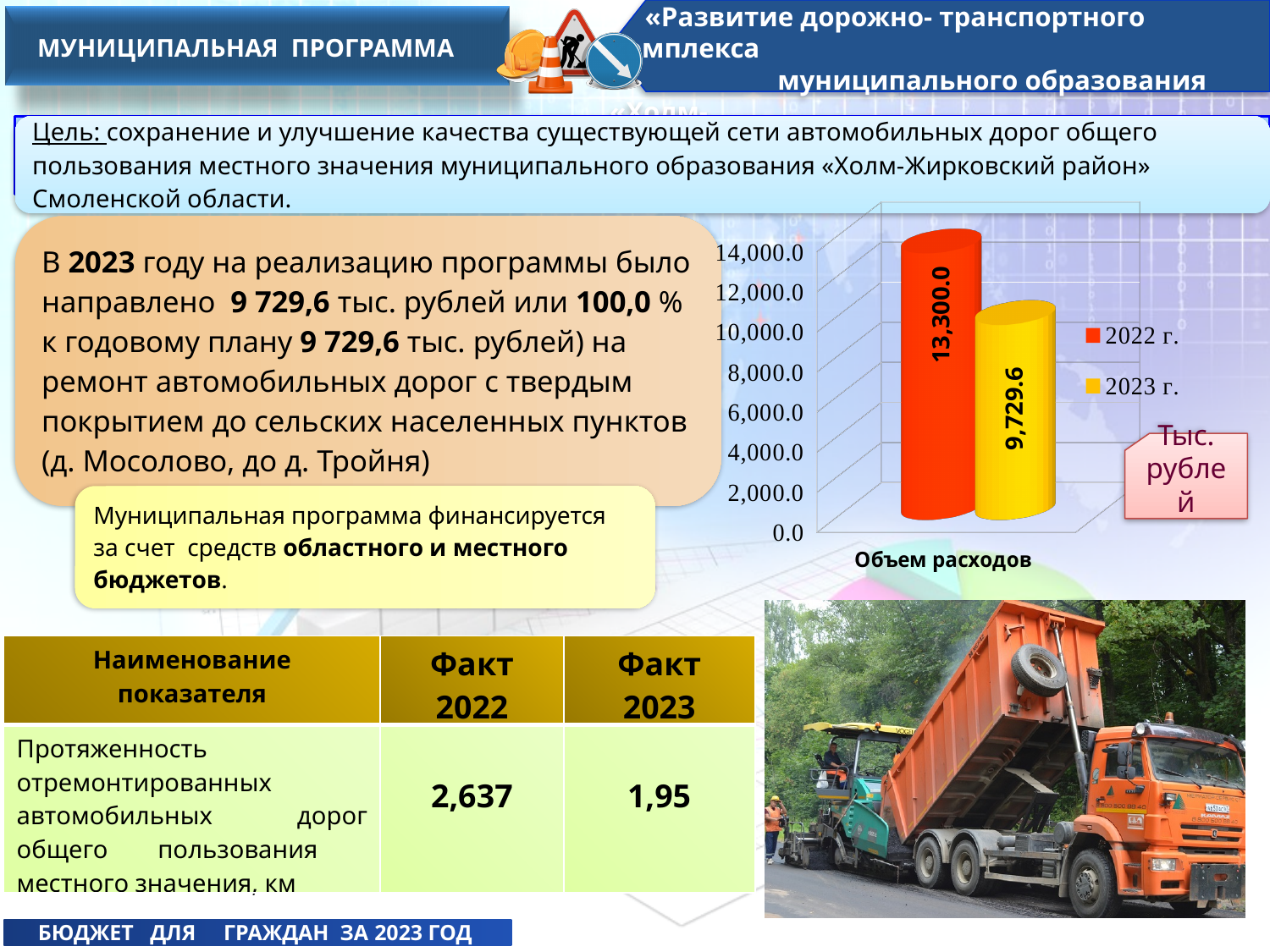
Is the value for 2023 г. greater or less than 10,000.0? less What is the category label shown under the bars of the chart? Объем расходов Which series has the highest value in the chart? 2022 г. What is the value of the 2023 г. bar in the chart? 9,729.6 Which series has the lowest value in the chart? 2023 г. Which series has the higher value in the chart, 2022 г. or 2023 г.? 2022 г. What colour is the 2023 г. bar in the chart? yellow What kind of chart is shown on the slide? bar chart What is the value of the 2022 г. bar in the chart? 13,300.0 Is the value for 2022 г. greater or less than 12,000.0? greater How many series does the chart legend list? 2 What is the difference between the 2022 г. and 2023 г. values in the chart? 3,570.4